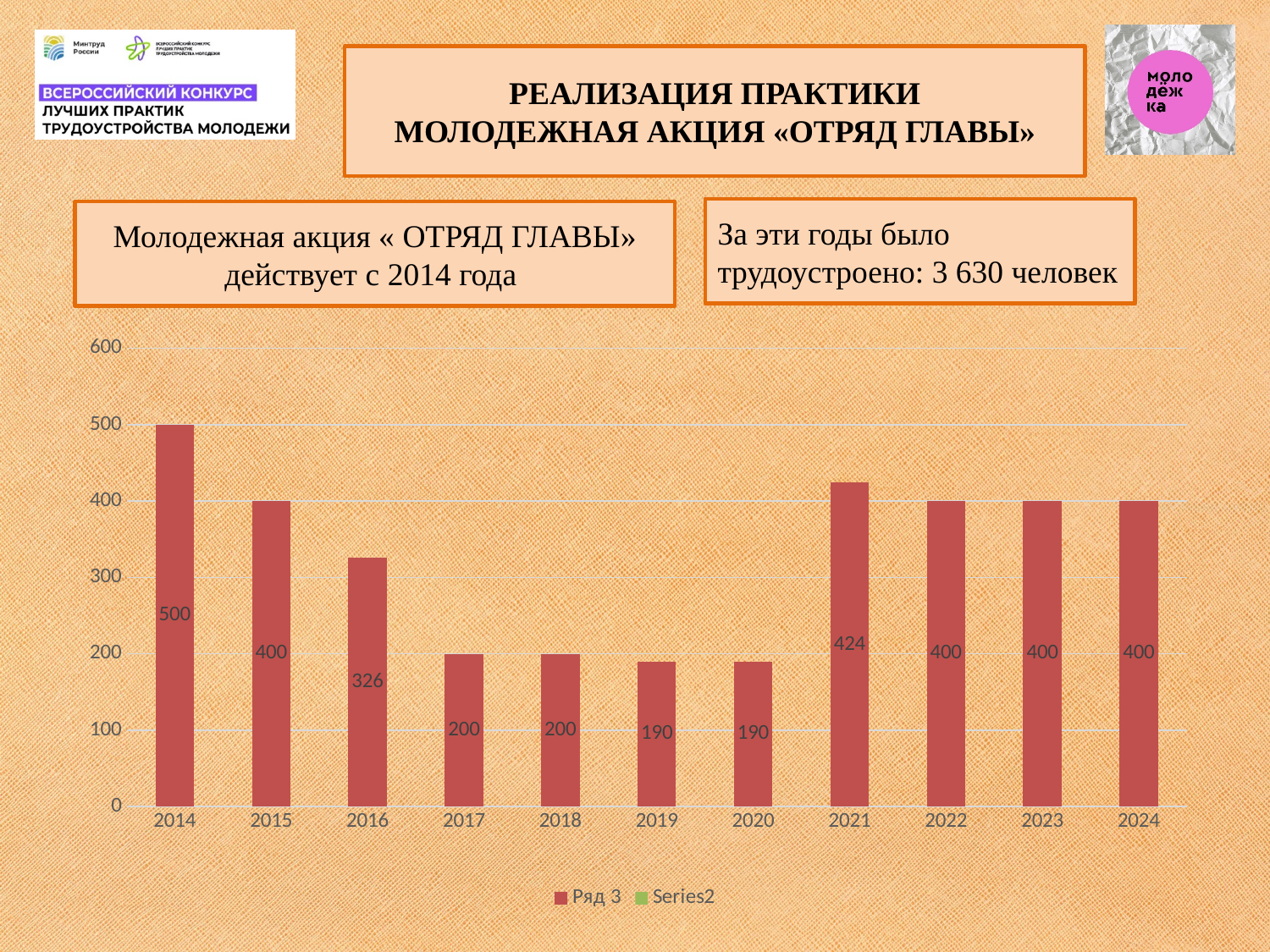
How many years are shown on the x axis? 11 What is the value for 2016? 326 Do the values rise or fall from 2014 to 2017? fall Which year has the highest value? 2014 How many series does the legend list? 2 What is the value for 2019? 190 What type of chart is shown on the slide? bar chart What is the value for 2021? 424 Which is larger, the value for 2021 or the value for 2022? 2021 What is the difference between the values for 2014 and 2021? 76 What is the difference between the values for 2016 and 2017? 126 What is the value for 2014? 500